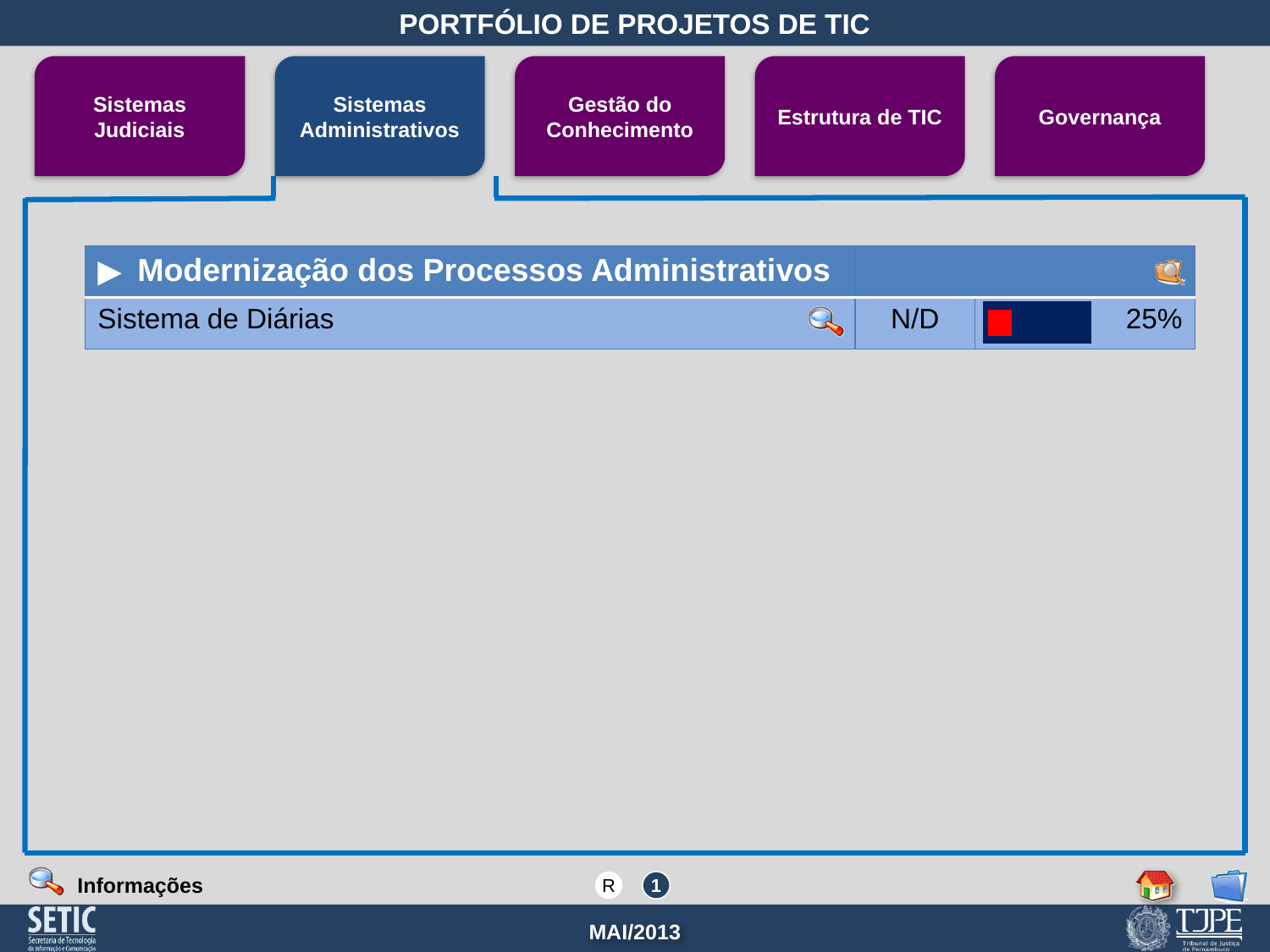
What kind of chart is used to show the progress of Sistema de Diárias? bar chart Is the progress value for Sistema de Diárias greater or less than 50%? less What is the title of the project group shown on the slide? Modernização dos Processos Administrativos How many projects are listed under Modernização dos Processos Administrativos? 1 What value is shown in the status column for Sistema de Diárias? N/D What completion percentage is shown for Sistema de Diárias? 25% What colour is the filled portion of the progress bar for Sistema de Diárias? red